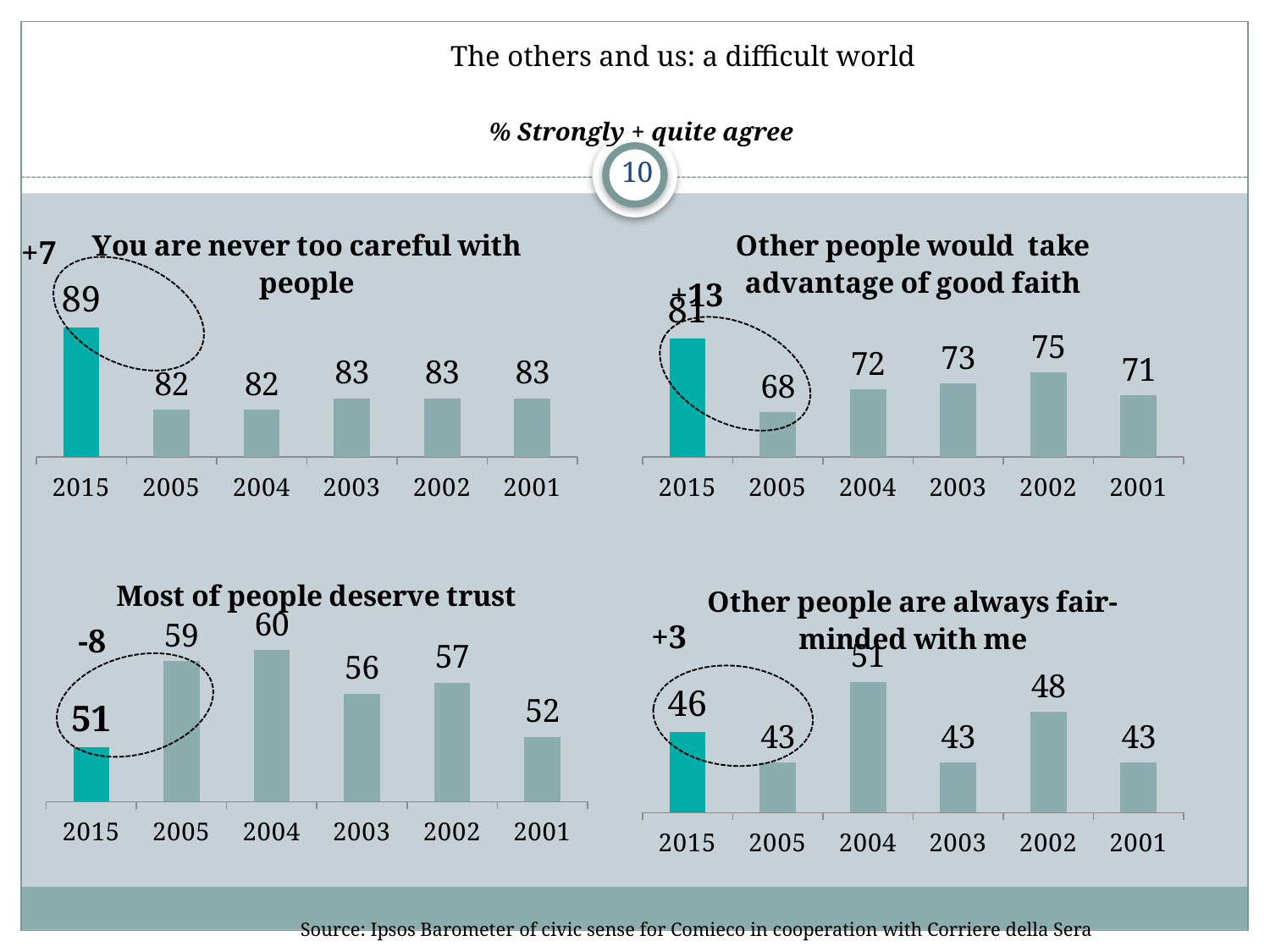
What kind of chart is "Other people would take advantage of good faith"? Bar chart In the chart titled "Other people are always fair-minded with me", what is the value for 2002? 48 In the chart titled "Most of people deserve trust", which year has the highest value? 2004 In the chart titled "You are never too careful with people", what is the value for 2015? 89 In the chart titled "Most of people deserve trust", which is larger, the value for 2015 or the value for 2001? 2001 In the chart titled "Other people would take advantage of good faith", which year has the lowest value? 2005 In the chart titled "Other people are always fair-minded with me", what is the difference between the values for 2004 and 2015? 5 In the chart titled "Most of people deserve trust", what is the value for 2015? 51 In the chart titled "You are never too careful with people", how many years are shown on the x axis? 6 In the chart titled "Other people would take advantage of good faith", what is the value for 2005? 68 In the chart titled "Other people would take advantage of good faith", what is the difference between the values for 2015 and 2005? 13 How many charts are shown on the slide? 4